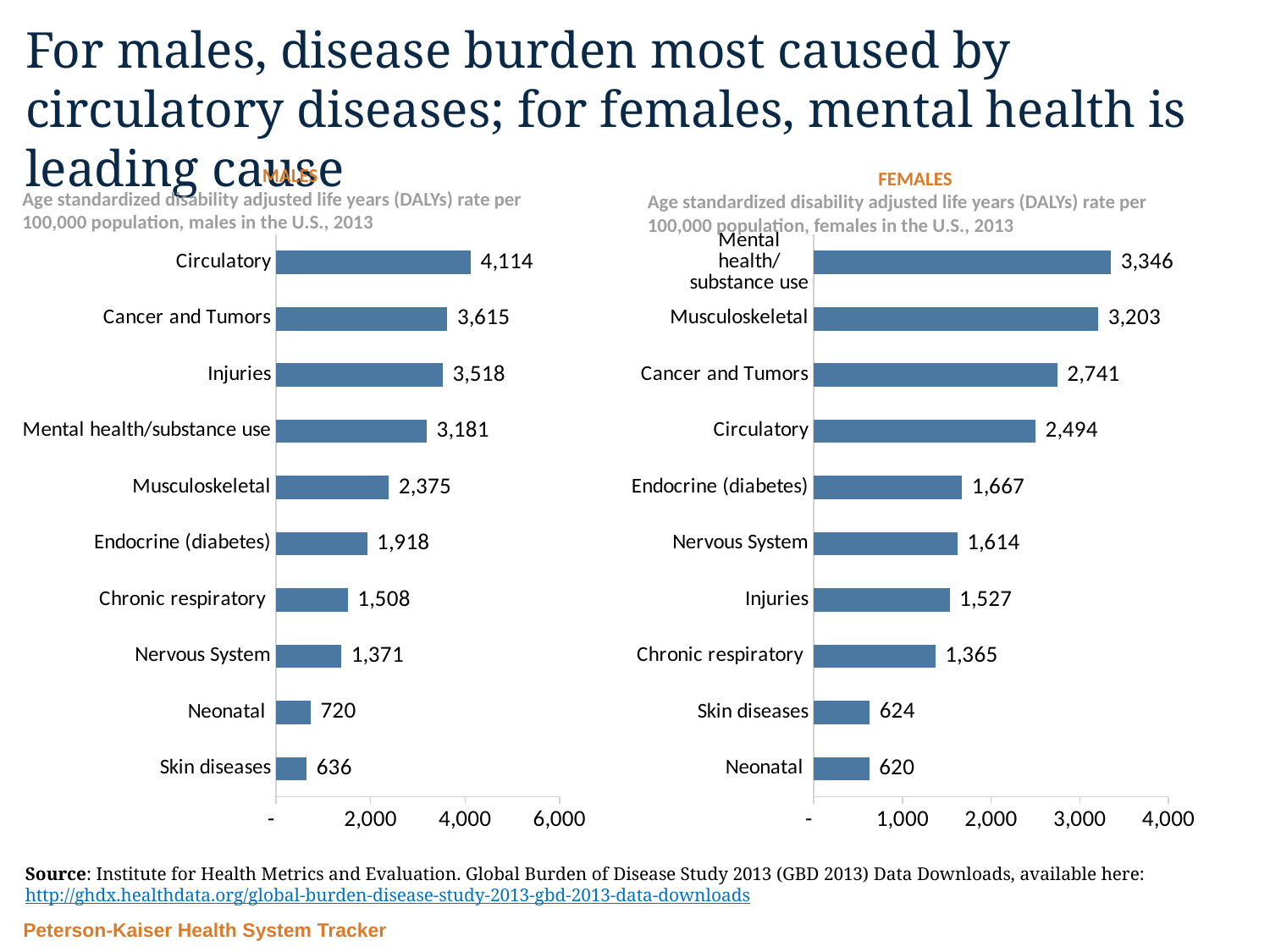
In the FEMALES chart, which category has the highest value? Mental health/ substance use In the MALES chart, is the value for Musculoskeletal greater or less than 2,000? greater What kind of chart is the FEMALES chart? Bar chart In the FEMALES chart, what is the difference between Injuries and Chronic respiratory? 162 In the FEMALES chart, what is the DALYs rate for Neonatal? 620 In the FEMALES chart, what is the DALYs rate for Musculoskeletal? 3,203 How many categories are shown in the MALES chart? 10 In the MALES chart, which is larger, Injuries or Mental health/substance use? Injuries In the MALES chart, what is the difference between Circulatory and Cancer and Tumors? 499 In the MALES chart, what is the DALYs rate for Circulatory? 4,114 In the FEMALES chart, which is larger, Endocrine (diabetes) or Nervous System? Endocrine (diabetes) In the MALES chart, which category has the lowest value? Skin diseases